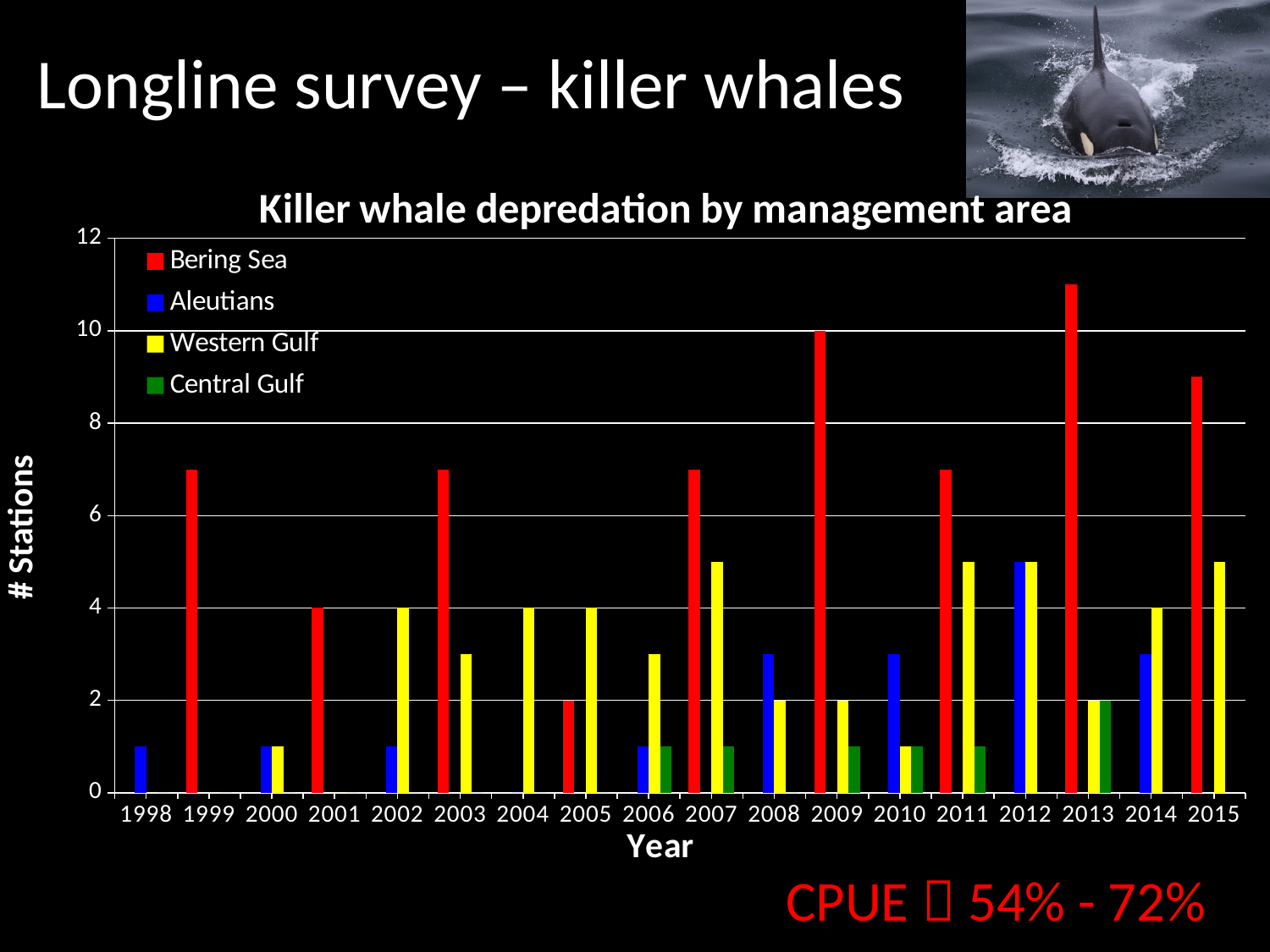
What is the title of the chart? Killer whale depredation by management area What kind of chart is shown on the slide? bar chart What is the number of stations for the Bering Sea in 2009? 10 How many series does the chart legend list? 4 What is the number of stations for the Bering Sea in 2001? 4 In 2009, which is larger: the Bering Sea value or the Western Gulf value? Bering Sea How many years are shown along the x axis of the chart? 18 What is the difference between the Bering Sea value and the Western Gulf value in 2009? 8 Is the Bering Sea value for 2013 greater or less than 10? greater In which year is the Bering Sea value highest? 2013 What is the number of stations for the Western Gulf in 2009? 2 Is the Aleutians value for 2012 greater or less than 4? greater